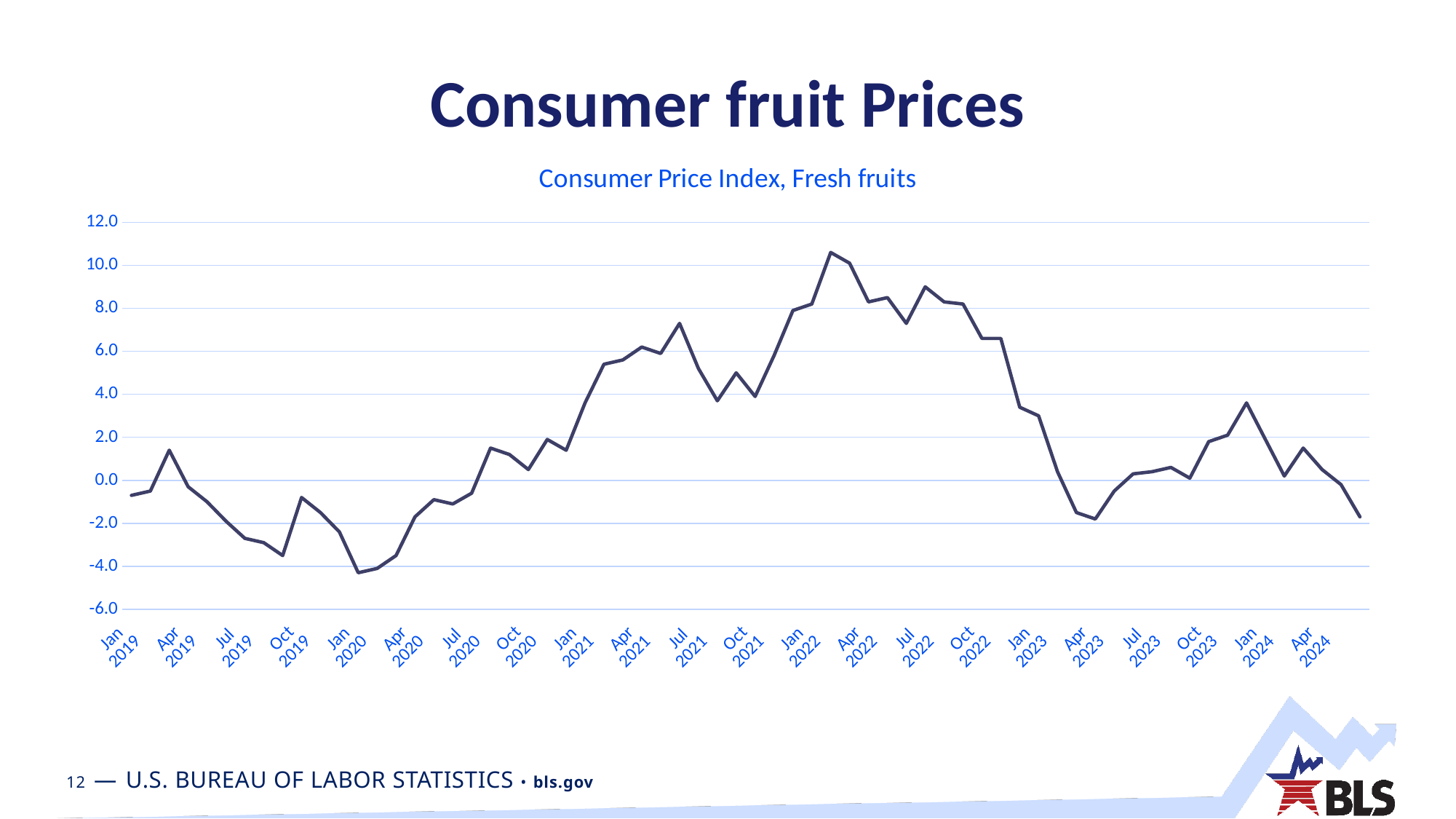
Is the value at Apr 2023 greater or less than 0.0? less Is the value at Jan 2019 greater or less than 0.0? less How many labels are shown on the x axis? 22 Around which x-axis label does the line reach its highest value? Jan 2022 What kind of chart is shown on the slide? line chart Is the value at Jul 2021 greater or less than 6.0? less What is the subtitle printed above the chart? Consumer Price Index, Fresh fruits Between Apr 2022 and Apr 2023, does the line generally rise or fall? fall Around which x-axis label does the line reach its lowest value? Jan 2020 Which is larger, the value at Jul 2021 or the value at Jul 2019? Jul 2021